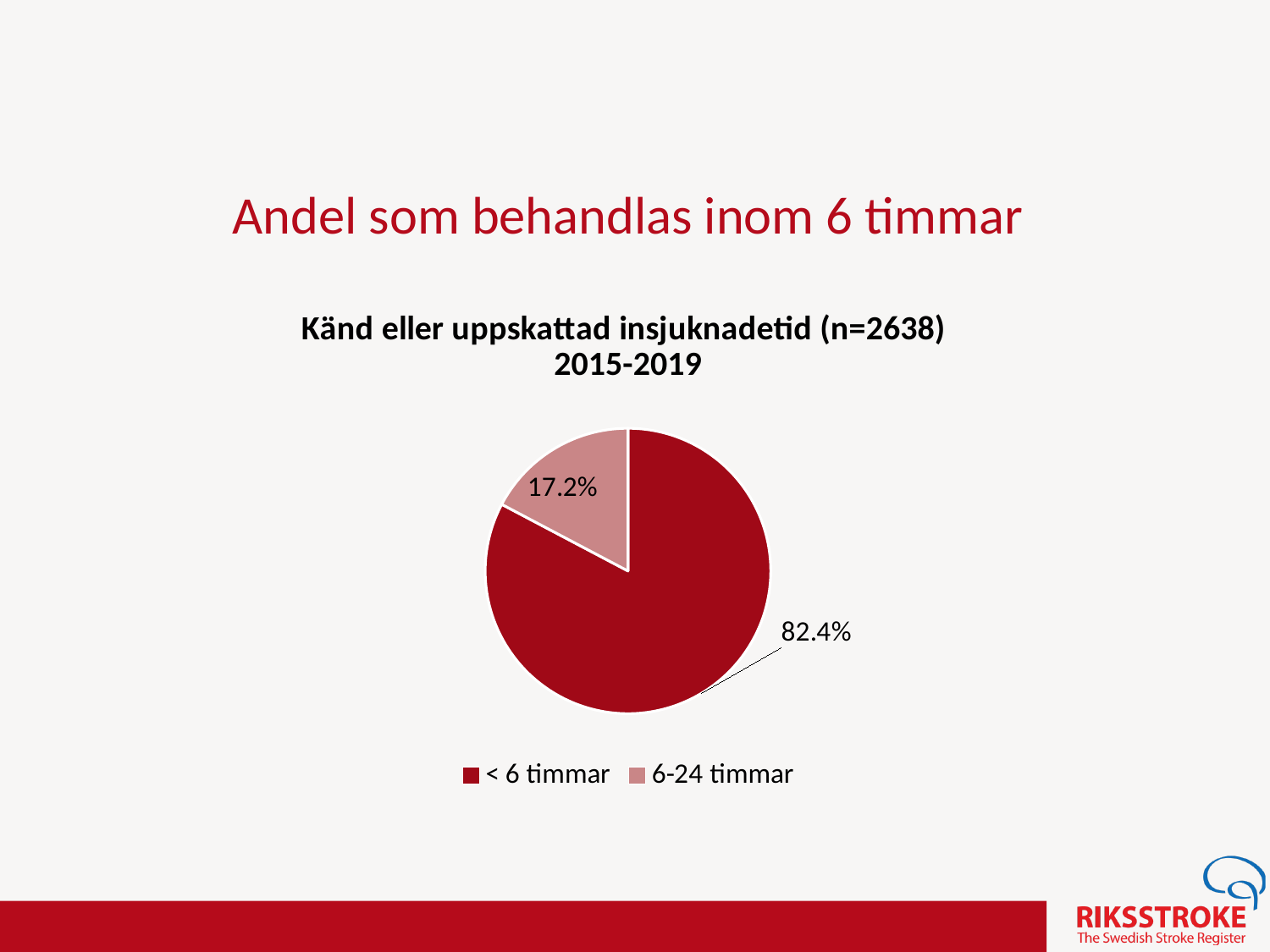
Which is larger, the "< 6 timmar" slice or the "6-24 timmar" slice? < 6 timmar What kind of chart is shown on the slide? pie chart Which slice of the pie is the smallest? 6-24 timmar What is the sample size (n) stated in the chart title? 2638 How many slices does the pie chart have? 2 Which slice of the pie is the largest? < 6 timmar What share of the pie does the "< 6 timmar" slice represent? 82.4% What is the title of the chart? Känd eller uppskattad insjuknadetid (n=2638) 2015-2019 How many entries does the legend list? 2 What is the difference in percentage points between the "< 6 timmar" and "6-24 timmar" slices? 65.2 What share of the pie does the "6-24 timmar" slice represent? 17.2%